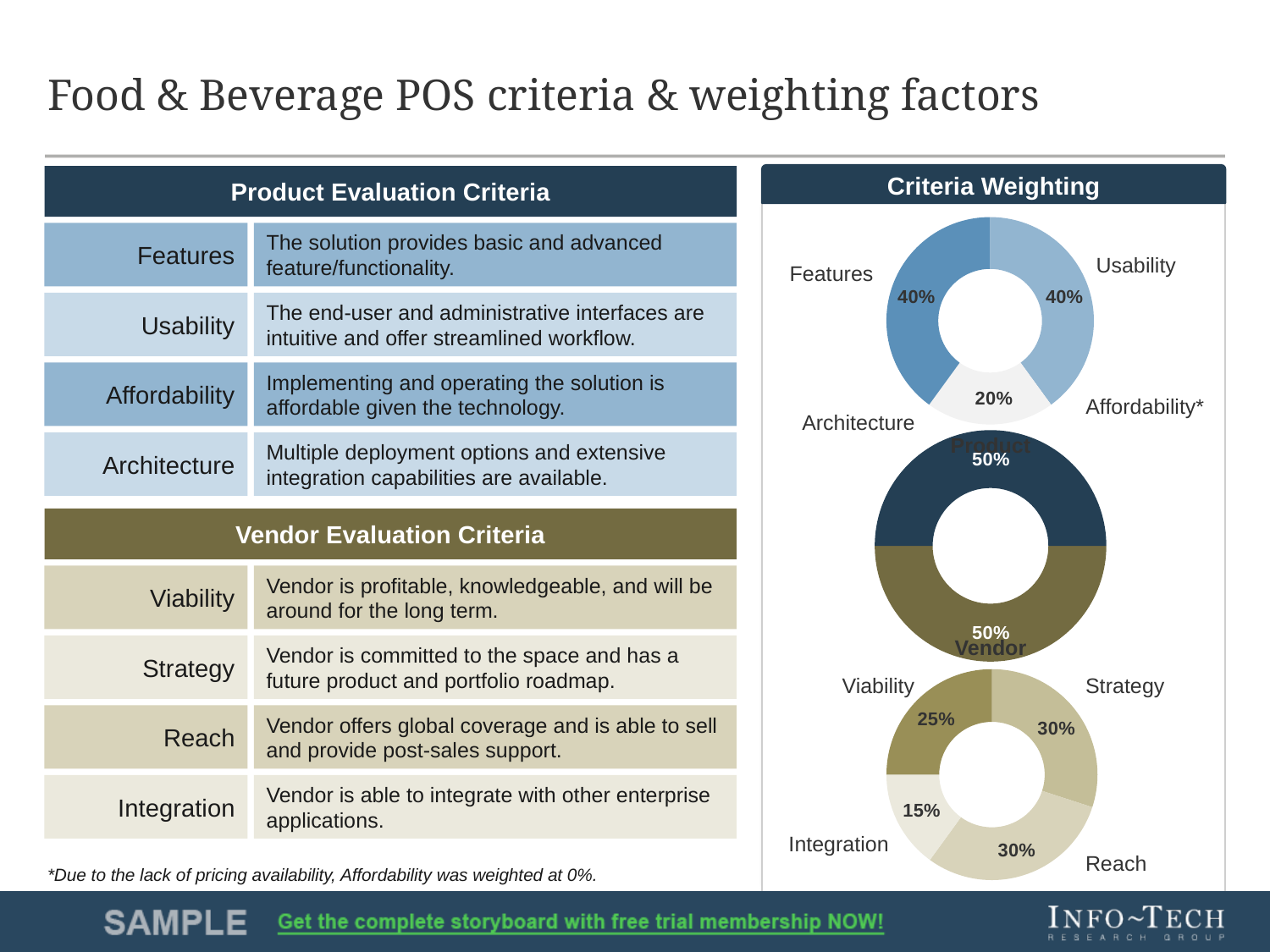
In the top donut chart under Criteria Weighting, which criterion has the lowest non-zero weighting? Architecture In the top donut chart under Criteria Weighting, what is the weighting for Usability? 40% In the middle donut chart under Criteria Weighting, what is the weighting for Product? 50% In the bottom donut chart under Criteria Weighting, what is the weighting for Integration? 15% In the bottom donut chart under Criteria Weighting, which is larger, the weighting for Reach or for Viability? Reach In the bottom donut chart under Criteria Weighting, what is the difference between the weightings for Strategy and Integration? 15% In the top donut chart under Criteria Weighting, what is the weighting for Architecture? 20% In the bottom donut chart under Criteria Weighting, what is the weighting for Viability? 25% In the middle donut chart under Criteria Weighting, what is the weighting for Vendor? 50% In the top donut chart under Criteria Weighting, what is the weighting for Features? 40% What kind of chart is used to show the Criteria Weighting? Donut chart In the bottom donut chart under Criteria Weighting, which criterion has the lowest weighting? Integration